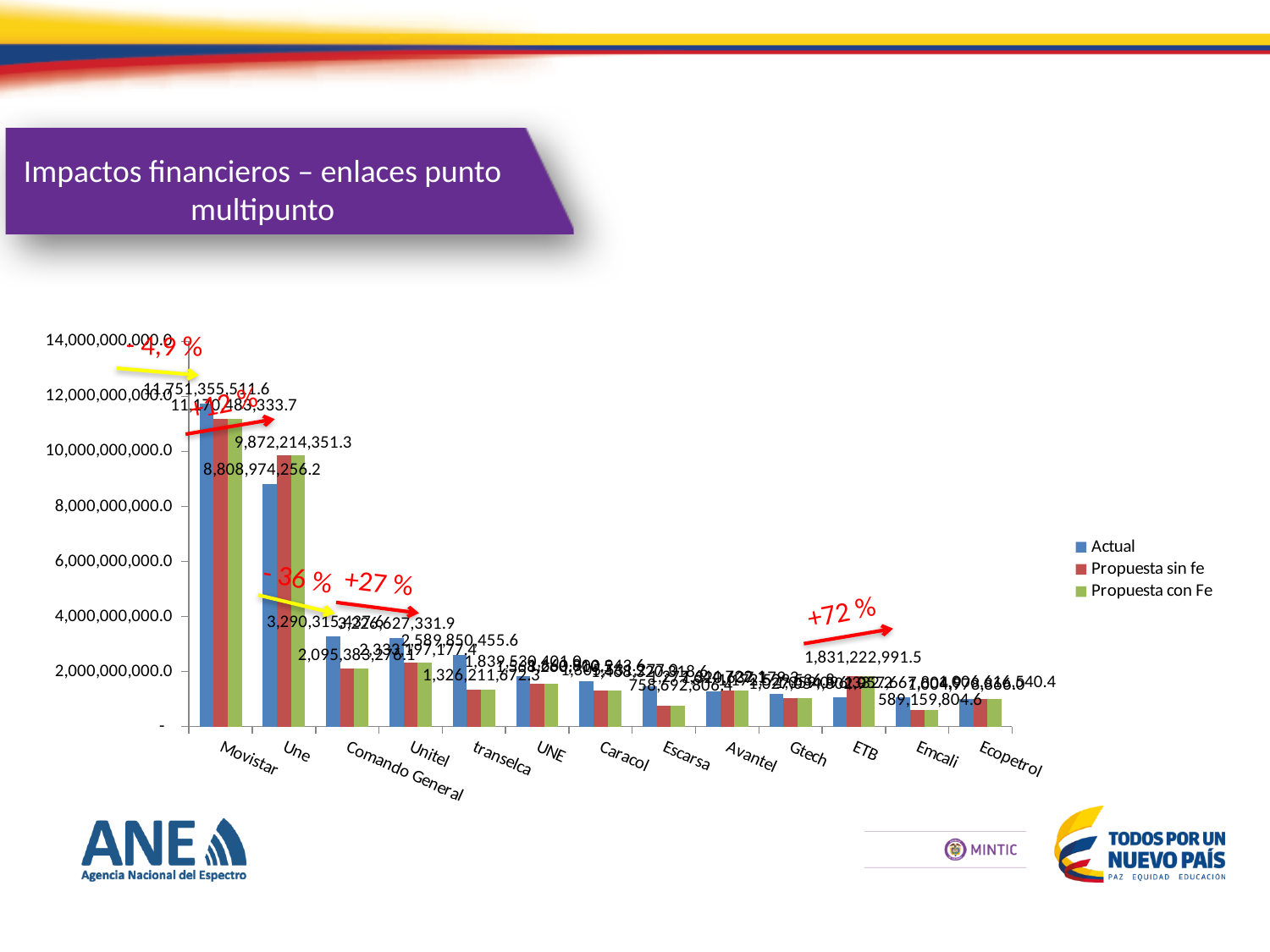
How many series does the legend list? 3 How many categories (companies) are shown on the x axis? 13 Is the Actual value for Ecopetrol greater or less than 2,000,000,000.0? less Do the Actual values generally rise or fall moving from left to right along the x axis? Fall What is the Actual value for Une? 8,808,974,256.2 What is the Actual value for Movistar? 11,751,355,511.6 What are the three series named in the legend? Actual, Propuesta sin fe, Propuesta con Fe What is the difference between the Propuesta sin fe value and the Actual value for Une? 1,063,240,095.1 For Une, which is larger: the Actual value or the Propuesta sin fe value? Propuesta sin fe What kind of chart is shown on the slide? Bar chart What is the Propuesta sin fe value for Une? 9,872,214,351.3 Which category has the highest Actual value? Movistar